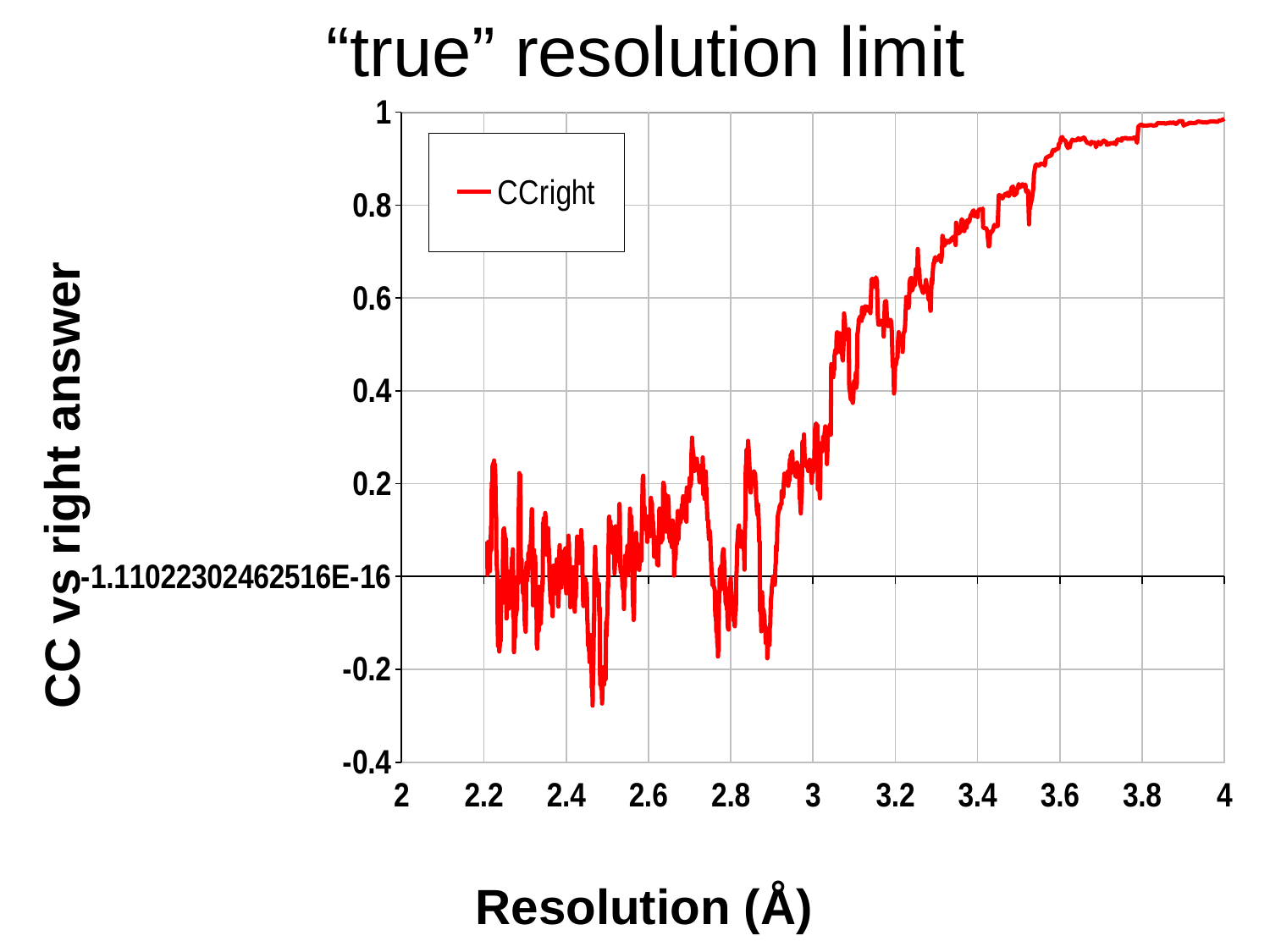
Is the CCright value at a resolution of 3.4 Å greater or less than 0.6? greater Is the CCright value higher at a resolution of 3.8 Å or at 2.6 Å? 3.8 Å Is the CCright value at a resolution of 2.4 Å greater or less than 0.2? less Is the CCright value at a resolution of 2.8 Å greater or less than 0.2? less Overall, does the CCright value rise or fall as resolution increases from 2.2 to 4 Å? Rise How many series does the legend list? 1 What is the name of the series shown in the legend? CCright What is the title of the chart? "true" resolution limit What kind of chart is shown on the slide? Line chart